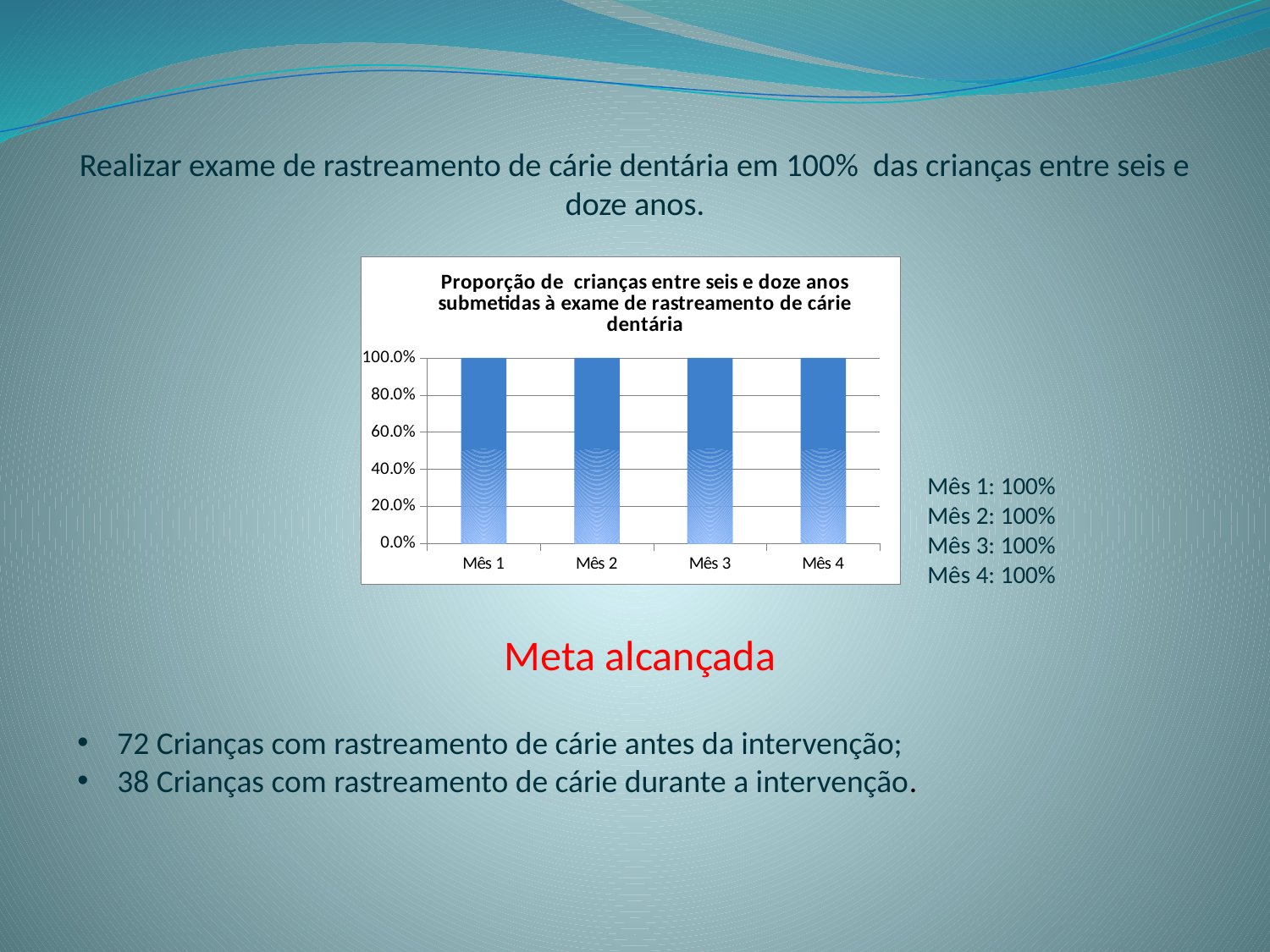
What is the value for Mês 3? 100% How many categories (months) are shown on the x axis? 4 What is the difference between the values for Mês 2 and Mês 4? 0% What is the value for Mês 4? 100% What is the highest value shown on the y axis? 100.0% What is the value for Mês 1? 100% What kind of chart is shown on the slide? bar chart What is the label of the first category on the x axis? Mês 1 Is the value for Mês 4 greater or less than 60.0%? greater Do the values rise, fall or stay the same from Mês 1 to Mês 4? stay the same Is the value for Mês 2 greater or less than 80.0%? greater